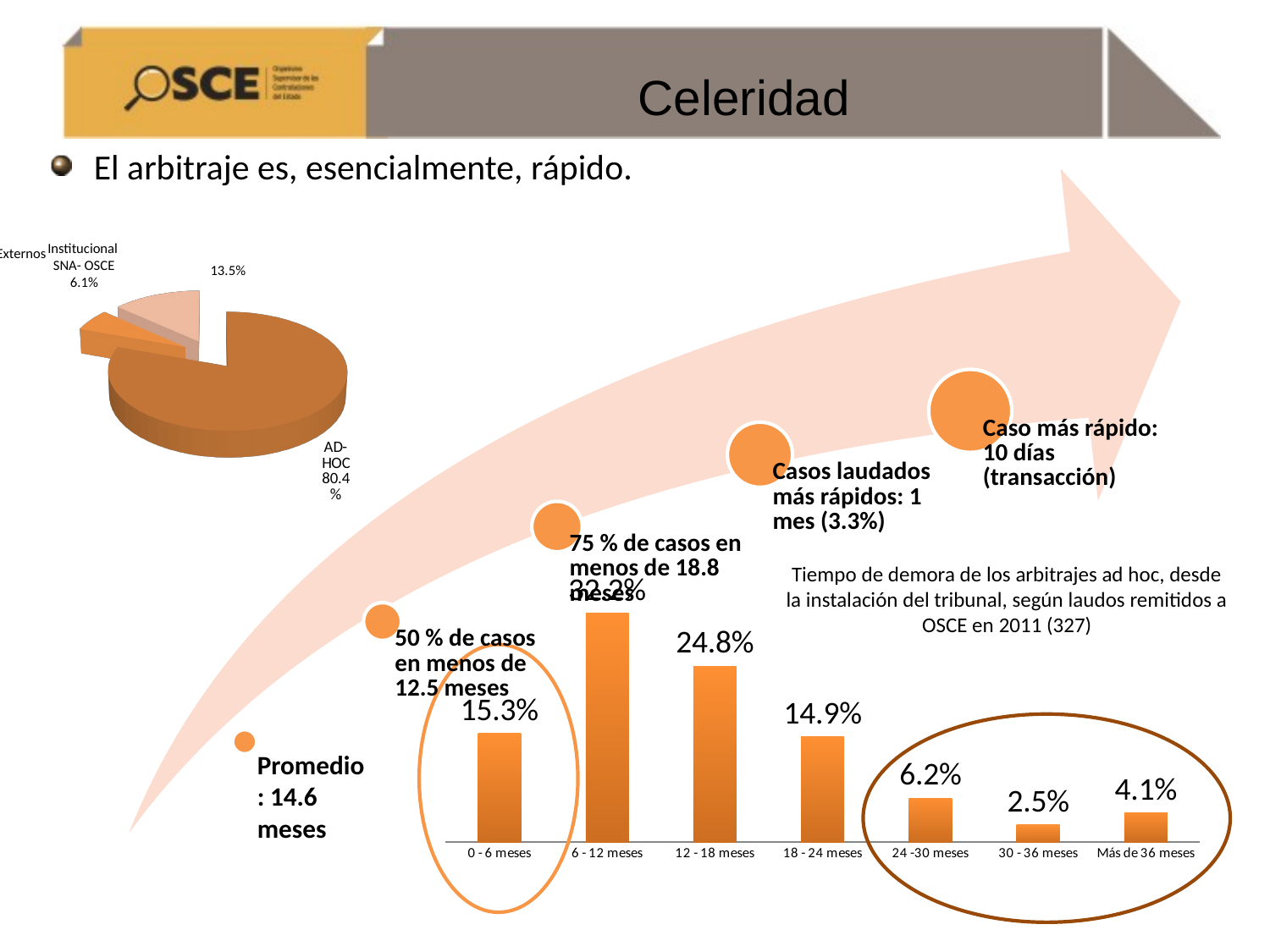
In the pie chart on the left of the slide, what is the share for 'AD-HOC'? 80.4% In the bar chart about 'Tiempo de demora de los arbitrajes ad hoc', what is the value for '30 - 36 meses'? 2.5% In the bar chart about 'Tiempo de demora de los arbitrajes ad hoc', what is the value for '12 - 18 meses'? 24.8% In the bar chart about 'Tiempo de demora de los arbitrajes ad hoc', what is the value for '0 - 6 meses'? 15.3% In the bar chart about 'Tiempo de demora de los arbitrajes ad hoc', what is the difference between the values for '12 - 18 meses' and '18 - 24 meses'? 9.9% How many categories are shown in the bar chart about 'Tiempo de demora de los arbitrajes ad hoc'? 7 What kind of chart is the chart at the bottom of the slide showing time ranges in months? Bar chart In the bar chart about 'Tiempo de demora de los arbitrajes ad hoc', which is larger: the value for '24 -30 meses' or 'Más de 36 meses'? 24 -30 meses In the bar chart about 'Tiempo de demora de los arbitrajes ad hoc', which category has the highest value? 6 - 12 meses In the pie chart on the left of the slide, what is the share for 'Institucional SNA- OSCE'? 6.1% What kind of chart is the chart on the left of the slide showing AD-HOC, Institucional SNA- OSCE and Externos? Pie chart In the bar chart about 'Tiempo de demora de los arbitrajes ad hoc', which category has the lowest value? 30 - 36 meses